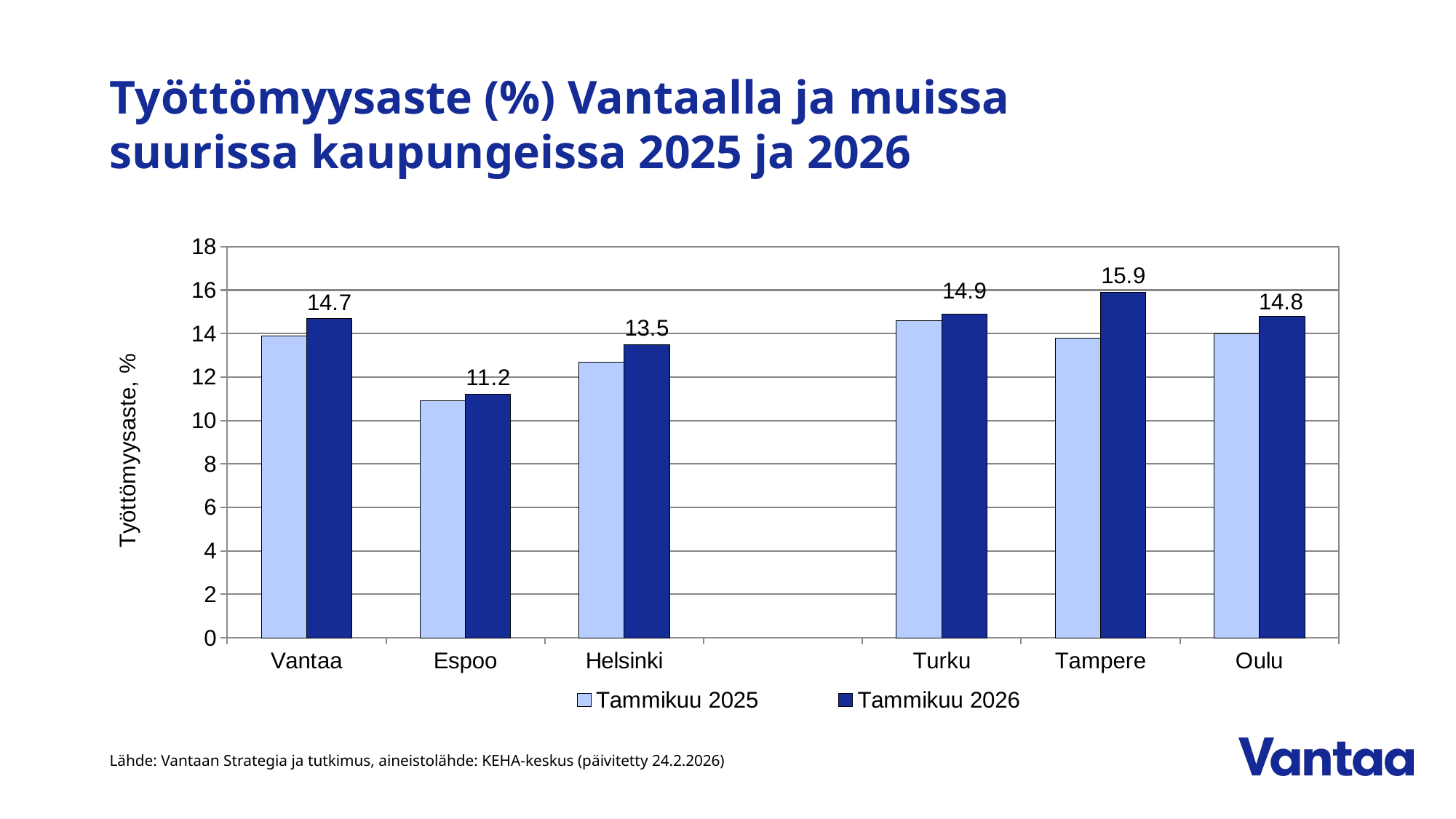
Which city has the highest unemployment rate in Tammikuu 2026? Tampere Is the Tammikuu 2025 unemployment rate for Espoo greater or less than 12? less What kind of chart is shown on the slide? bar chart Which city has the lowest unemployment rate in Tammikuu 2026? Espoo What is the unemployment rate for Vantaa in Tammikuu 2026? 14.7 How many series does the legend list? 2 What is the difference between the Tammikuu 2026 unemployment rates of Tampere and Espoo? 4.7 What is the unemployment rate for Espoo in Tammikuu 2026? 11.2 What is the unemployment rate for Tampere in Tammikuu 2026? 15.9 What is the unemployment rate for Helsinki in Tammikuu 2026? 13.5 Which is larger, the Tammikuu 2026 unemployment rate for Turku or for Oulu? Turku How many cities are shown on the x axis of the chart? 6